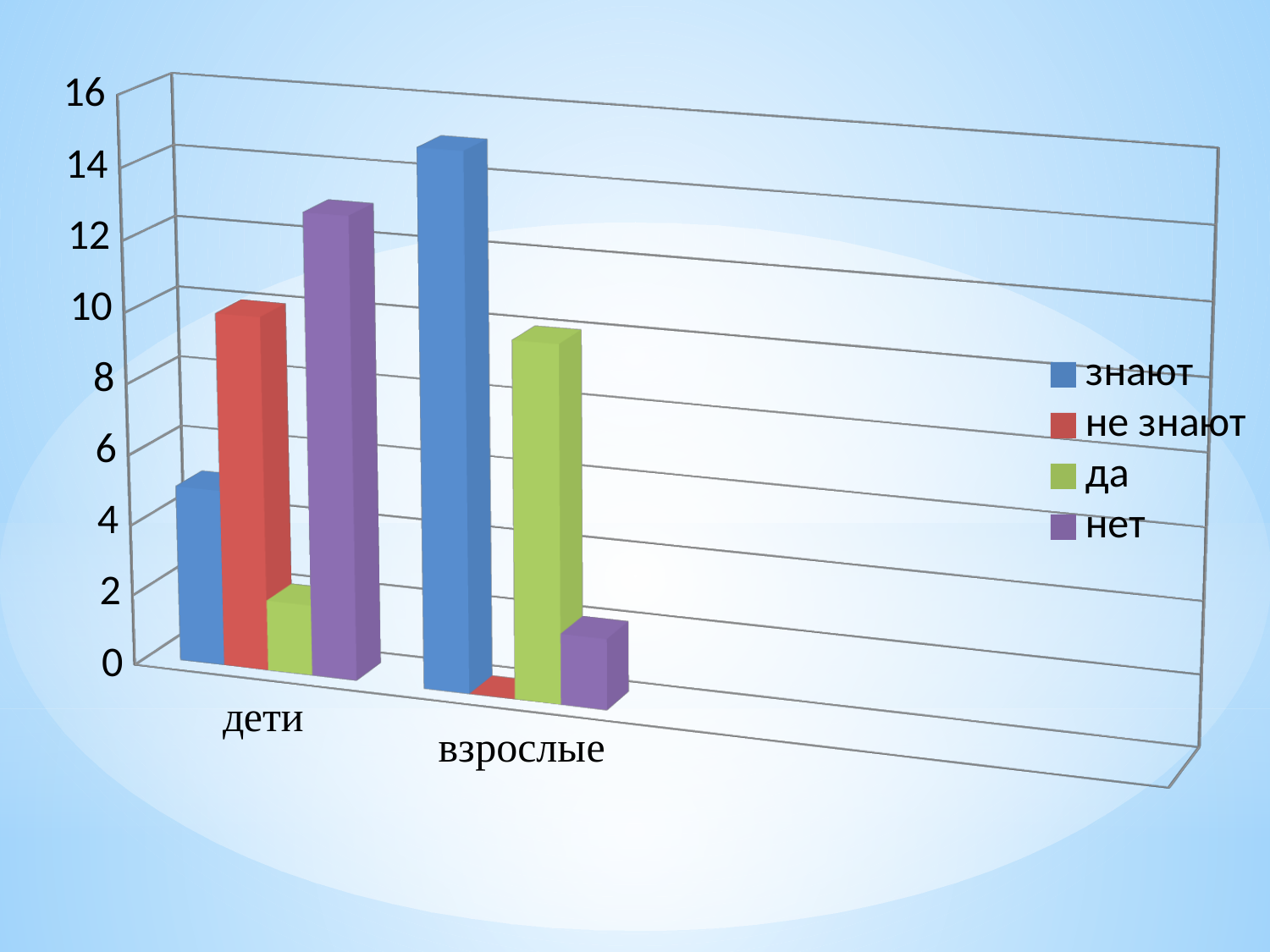
Which series has the shortest bar in the взрослые category? не знают Is the value for нет in the взрослые category greater or less than 4? less What colour represents the series да in the legend? green Is the value for знают in the взрослые category greater or less than 12? greater Which series has the tallest bar in the дети category? нет How many categories are shown on the x axis? 2 Is the value for не знают in the дети category greater or less than 8? greater What kind of chart is shown on the slide? bar chart How many series does the legend list? 4 In the дети category, which is larger: знают or не знают? не знают Which bar is the tallest in the whole chart? знают for взрослые